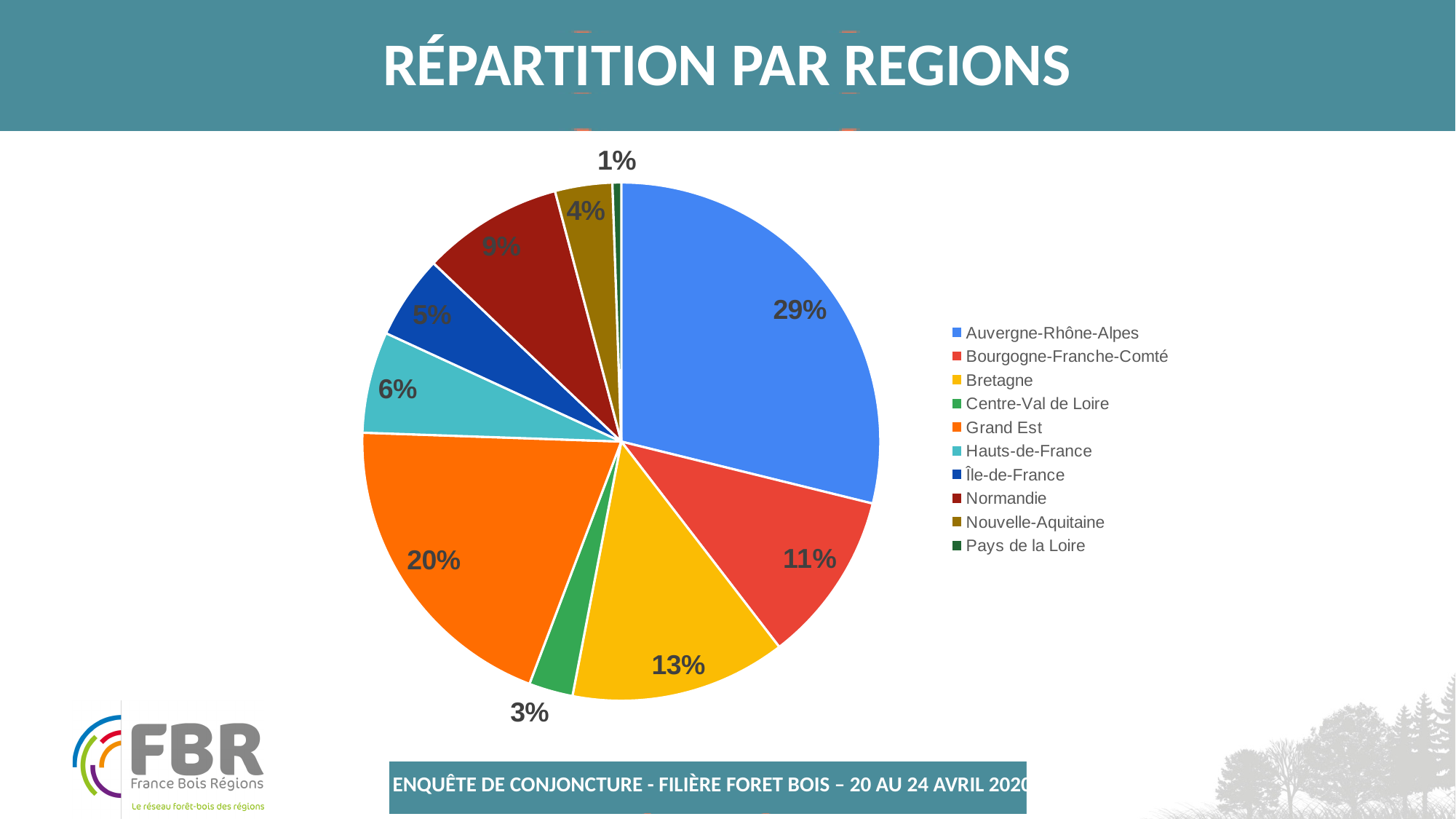
What kind of chart is shown on the slide? Pie chart What is the value for Bretagne? 13% What is the value for Centre-Val de Loire? 3% What is the difference between the shares of Grand Est and Bourgogne-Franche-Comté? 9% What is the title of the slide containing the chart? RÉPARTITION PAR REGIONS How many regions are listed in the legend? 10 What is the value for Grand Est? 20% Which is larger, the share for Hauts-de-France or the share for Île-de-France? Hauts-de-France What share of the pie does Auvergne-Rhône-Alpes hold? 29% Which region has the smallest share of the pie? Pays de la Loire Which region has the largest share of the pie? Auvergne-Rhône-Alpes What is the value for Normandie? 9%